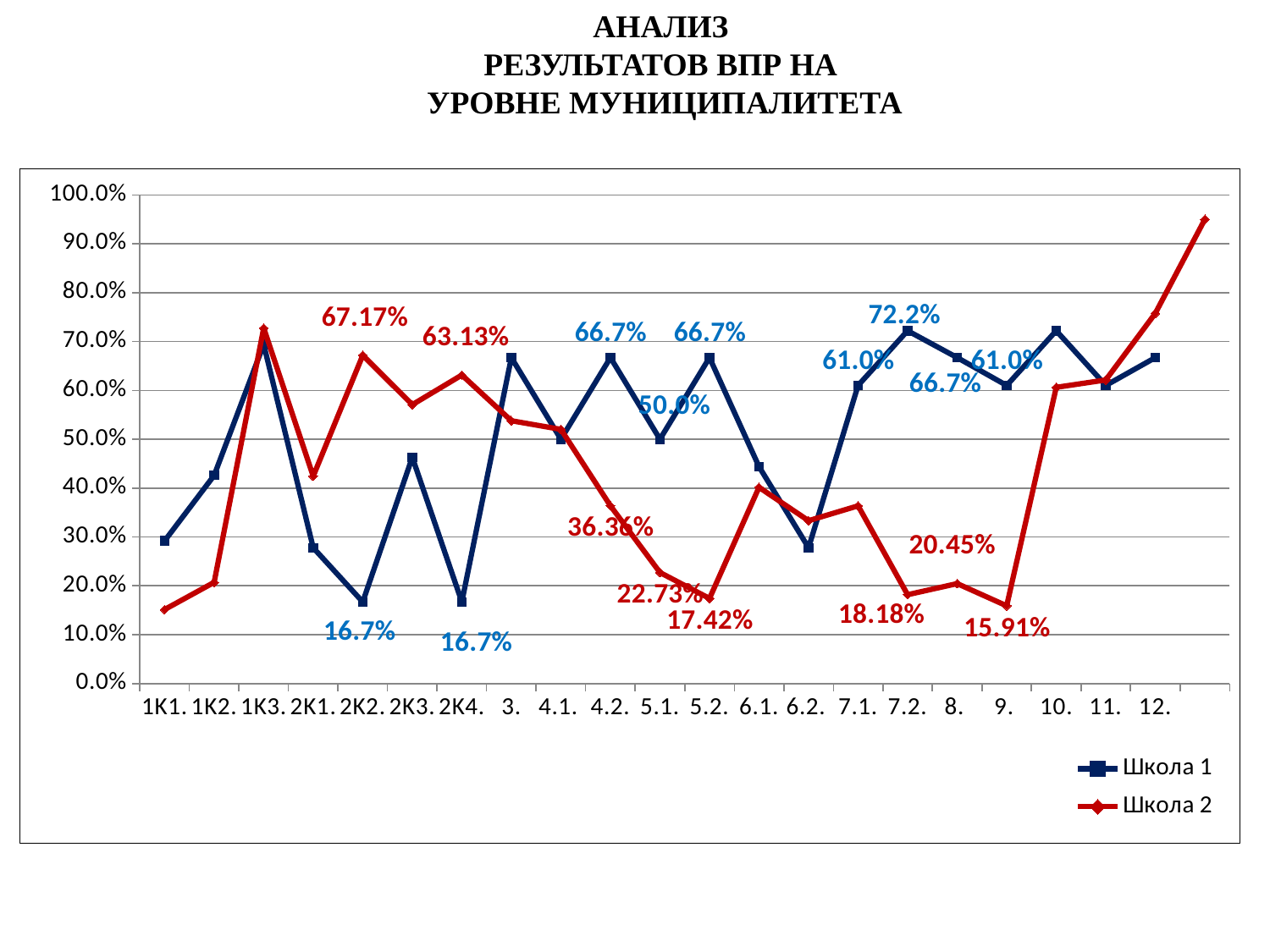
What is the value for Школа 1 at 7.2.? 72.2% Which series has the larger value at 5.2., Школа 1 or Школа 2? Школа 1 What type of chart is shown on the slide? Line chart What is the value for Школа 2 at 4.2.? 36.36% Which series has the larger value at 2К4., Школа 1 or Школа 2? Школа 2 What is the value for Школа 1 at 5.1.? 50.0% What is the difference between Школа 2 and Школа 1 at 2К2.? 50.47 percentage points What is the value for Школа 2 at 9.? 15.91% Is the value for Школа 2 at 1К1. greater or less than 20%? less Is the value for Школа 1 at 1К3. greater or less than 60%? greater How many series does the legend list? 2 What is the value for Школа 2 at 2К2.? 67.17%